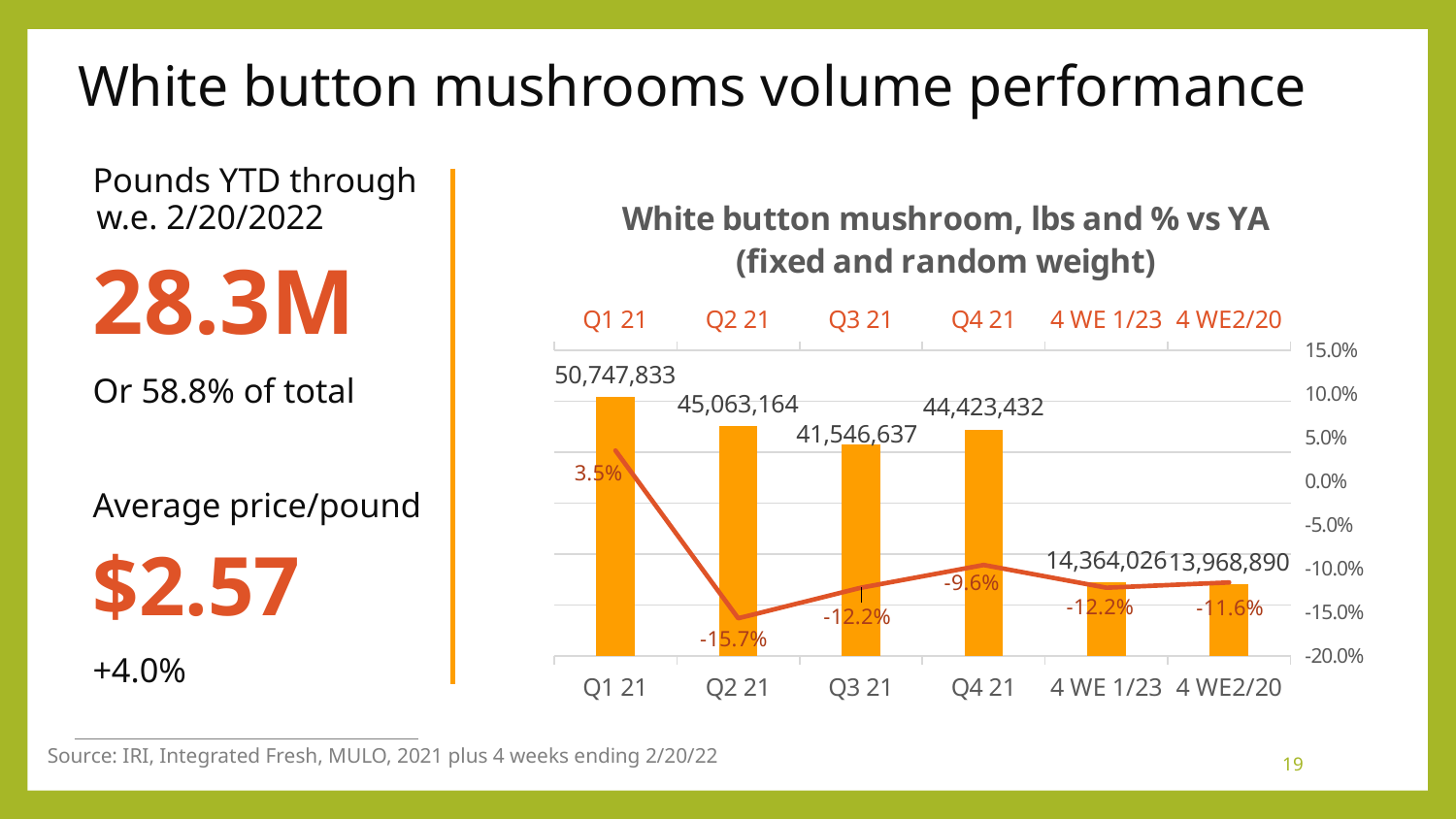
How many periods are shown on the x axis? 6 Which period has the highest pounds value? Q1 21 What is the % vs YA value for Q2 21? -15.7% Which period has the lowest pounds value? 4 WE2/20 What is the pounds value for Q1 21? 50,747,833 What is the title of the chart? White button mushroom, lbs and % vs YA (fixed and random weight) What is the pounds value for Q3 21? 41,546,637 What kind of chart is this? Combination bar and line chart What is the % vs YA value for 4 WE2/20? -11.6% Which period has the lowest % vs YA value? Q2 21 Which has a higher pounds value, Q3 21 or Q4 21? Q4 21 What is the difference in pounds between Q1 21 and Q2 21? 5,684,669